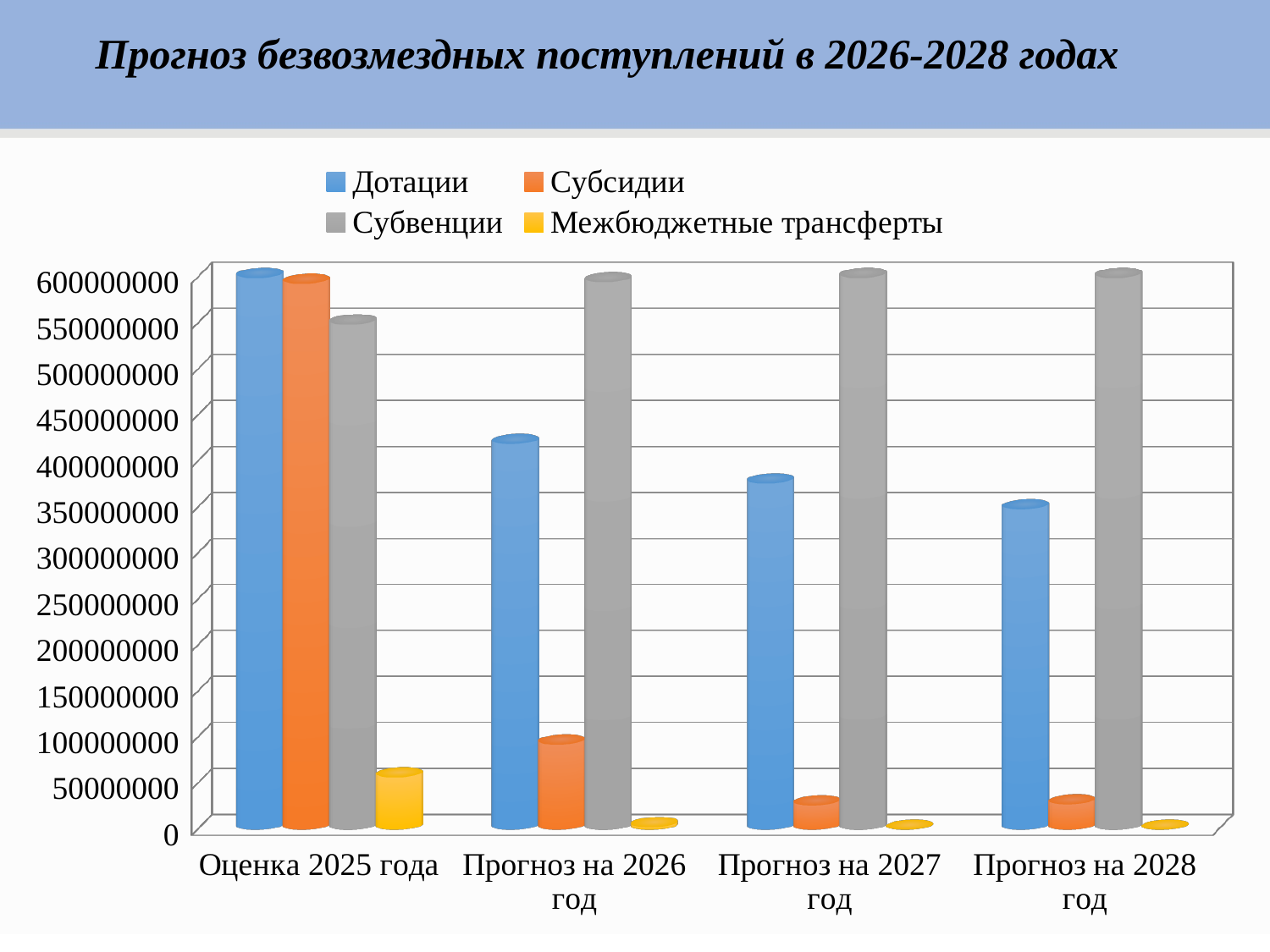
How many categories are shown along the x axis? 4 In which category is the value for Дотации the lowest? Прогноз на 2028 год In Прогноз на 2027 год, which is larger: Дотации or Субсидии? Дотации How many series does the legend list? 4 Is the value for Дотации in Прогноз на 2027 год greater or less than 350000000? greater Is the value for Субсидии in Прогноз на 2026 год greater or less than 150000000? less Which series has the lowest value in Оценка 2025 года? Межбюджетные трансферты What kind of chart is shown on the slide? bar chart Do the values for Дотации rise or fall from Оценка 2025 года to Прогноз на 2028 год? fall Is the value for Дотации in Прогноз на 2028 год greater or less than 400000000? less Which series has the highest value in Прогноз на 2026 год? Субвенции What is the title of the slide? Прогноз безвозмездных поступлений в 2026-2028 годах